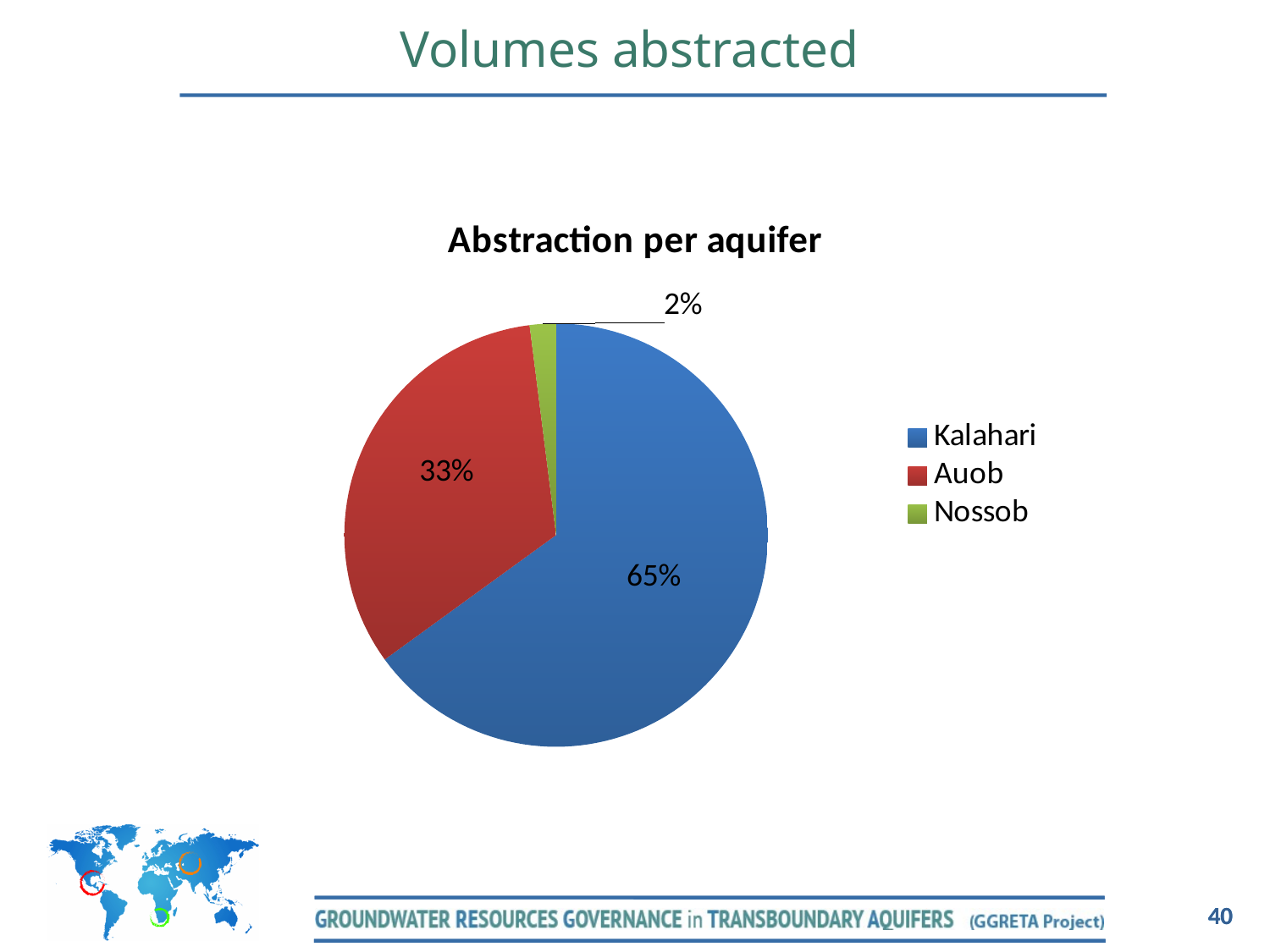
Which has a larger share of abstraction, Auob or Nossob? Auob What share of abstraction does the Nossob aquifer account for? 2% What share of abstraction does the Auob aquifer account for? 33% What is the difference in percentage points between the Auob and Nossob shares? 31 What kind of chart is shown on the slide? pie chart How many aquifers are shown in the pie chart? 3 What share of abstraction does the Kalahari aquifer account for? 65% Which aquifer has the smallest share of abstraction? Nossob What is the difference in percentage points between the Kalahari and Auob shares? 32 What colour represents the Auob aquifer in the chart? red Which aquifer has the largest share of abstraction? Kalahari What is the title of the chart? Abstraction per aquifer